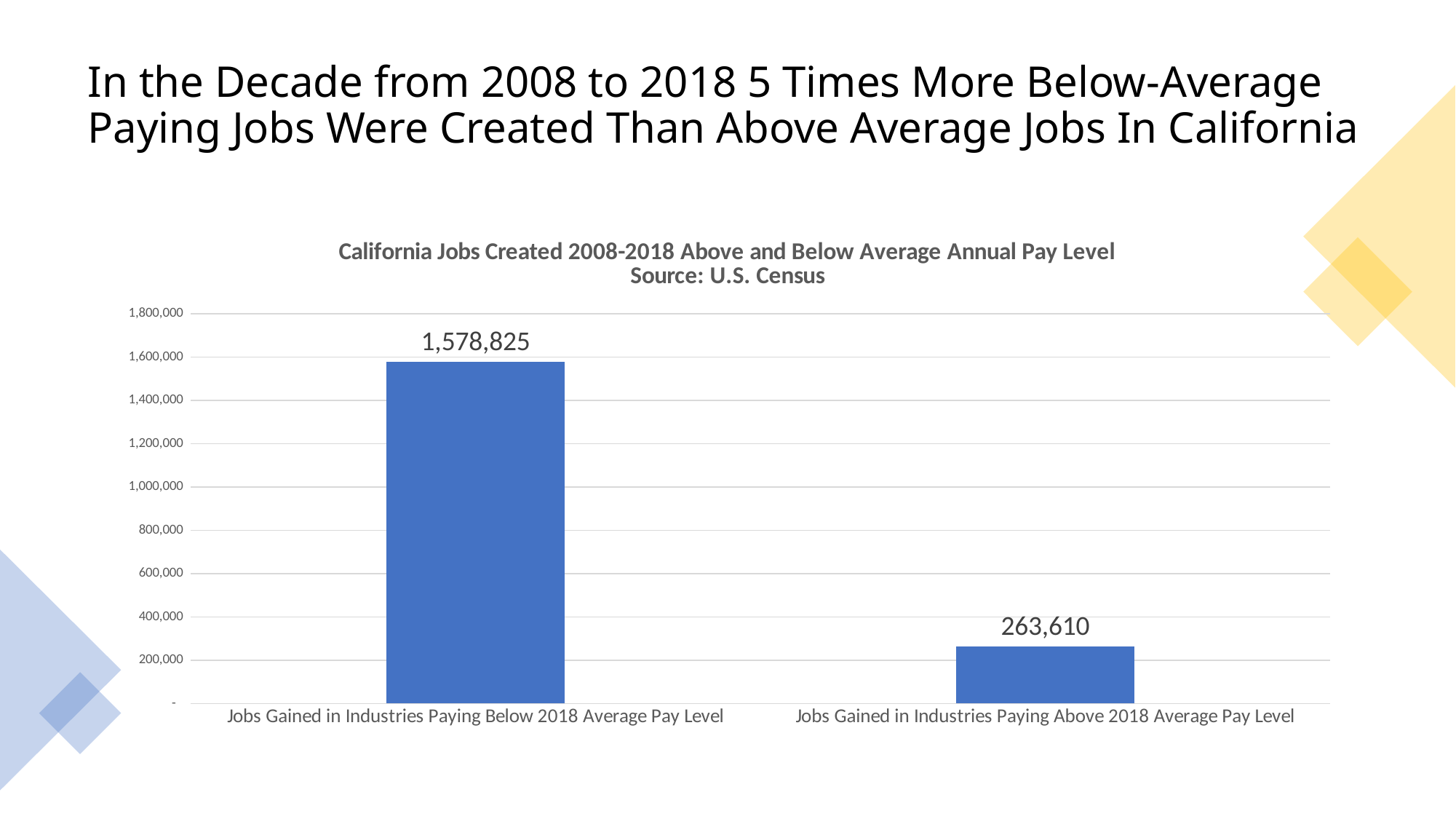
Is the value for Jobs Gained in Industries Paying Below 2018 Average Pay Level greater or less than 1,400,000? greater Which is larger: jobs gained in industries paying below the 2018 average pay level or jobs gained in industries paying above it? Jobs Gained in Industries Paying Below 2018 Average Pay Level Which category has the highest value? Jobs Gained in Industries Paying Below 2018 Average Pay Level What is the title of the chart? California Jobs Created 2008-2018 Above and Below Average Annual Pay Level Is the value for Jobs Gained in Industries Paying Above 2018 Average Pay Level greater or less than 400,000? less What is the value for Jobs Gained in Industries Paying Above 2018 Average Pay Level? 263,610 Which category has the lowest value? Jobs Gained in Industries Paying Above 2018 Average Pay Level What is the value for Jobs Gained in Industries Paying Below 2018 Average Pay Level? 1,578,825 How many categories are shown in the chart? 2 What kind of chart is shown on the slide? Bar chart What is the difference between the jobs gained in industries paying below the 2018 average pay level and those paying above it? 1,315,215 What source is cited in the chart title? U.S. Census